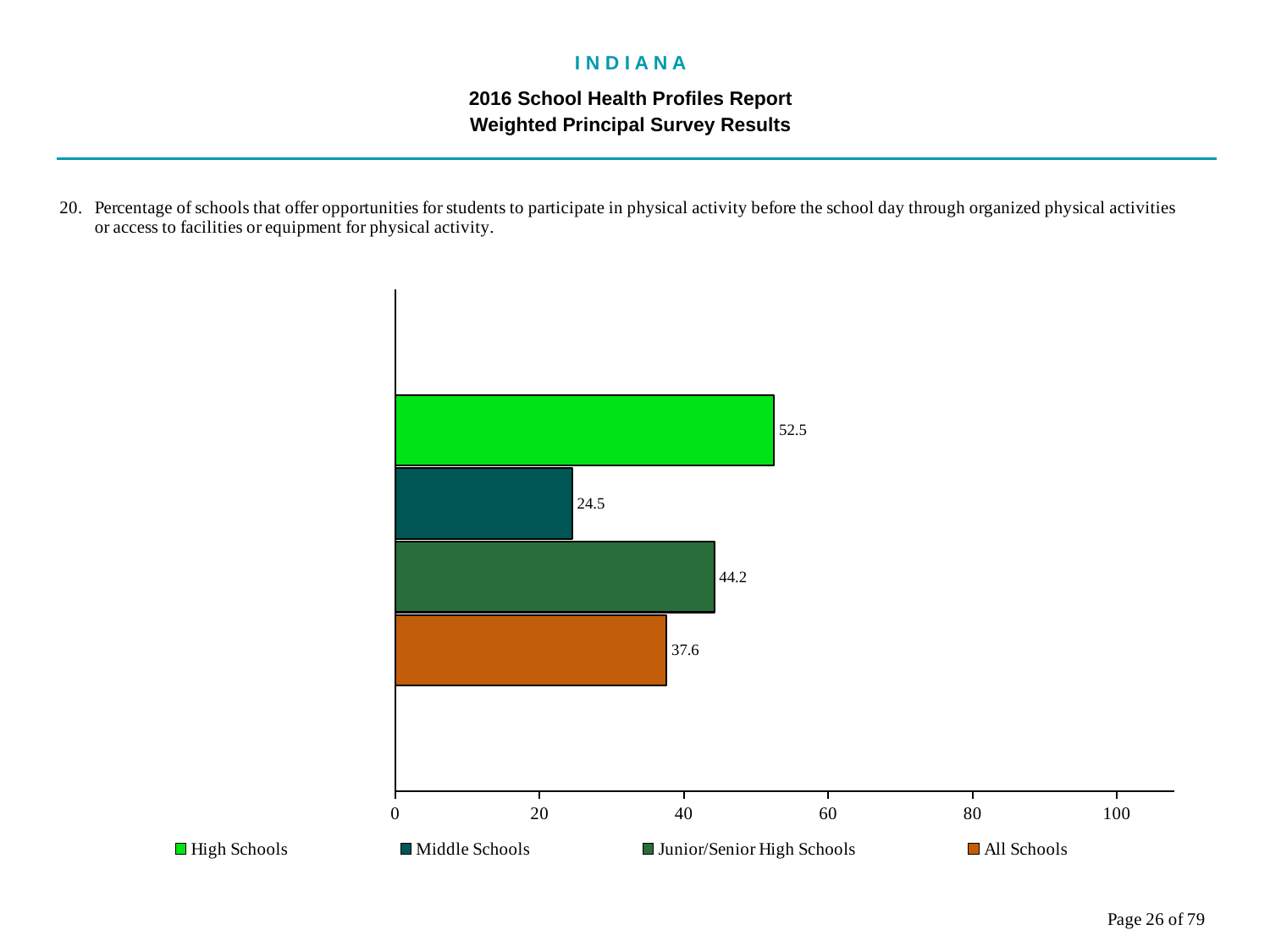
What is the value for Junior/Senior High Schools? 44.2 What kind of chart is shown on the slide? bar chart What is the value for Middle Schools? 24.5 Is the value for High Schools greater or less than 40? greater What is the difference between the values for Junior/Senior High Schools and All Schools? 6.6 Which school type has the lowest value? Middle Schools How many series does the legend list? 4 Which is larger, the value for Junior/Senior High Schools or the value for All Schools? Junior/Senior High Schools What is the value for All Schools? 37.6 What is the value for High Schools? 52.5 Which school type has the highest value? High Schools What is the difference between the values for High Schools and Middle Schools? 28.0